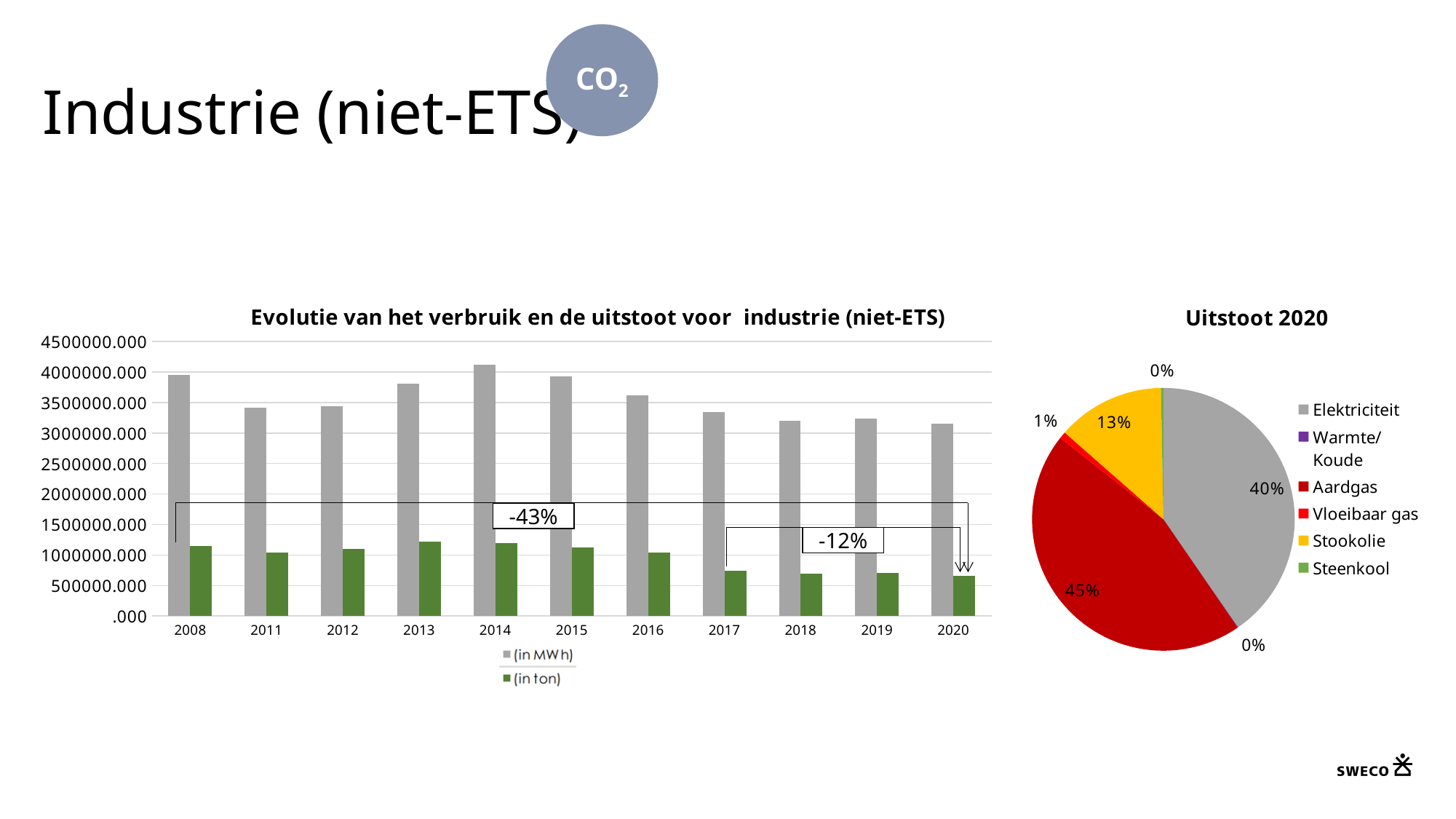
In the pie chart 'Uitstoot 2020', what share does Stookolie have? 13% In the pie chart 'Uitstoot 2020', which category has the largest share? Aardgas In the pie chart 'Uitstoot 2020', how many categories does the legend list? 6 In the left bar chart, which is larger: the '(in MWh)' value for 2014 or for 2020? 2014 In the left bar chart, how many series does the legend list? 2 In the left bar chart, how many years are shown on the x axis? 11 In the left bar chart, is the '(in ton)' value for 2020 greater or less than 1000000.000? less In the left bar chart, is the '(in MWh)' value for 2008 greater or less than 3500000.000? greater What kind of chart is the left chart titled 'Evolutie van het verbruik en de uitstoot voor industrie (niet-ETS)'? bar chart In the pie chart 'Uitstoot 2020', what share does Aardgas have? 45% In the left bar chart, which year has the highest value for the '(in MWh)' series? 2014 In the left bar chart, what percentage change is annotated between 2008 and 2020? -43%